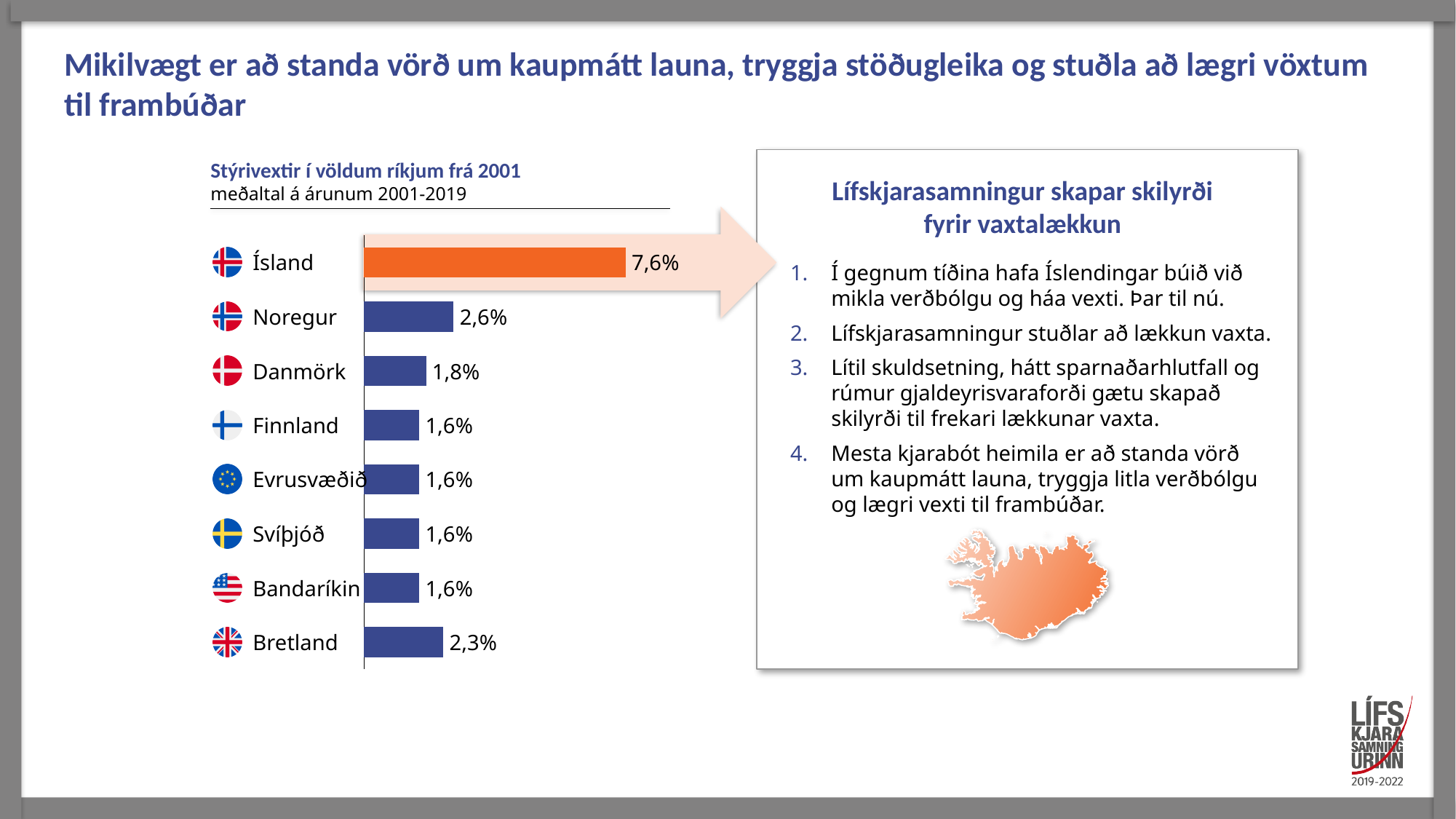
Which is larger, the value for Noregur or the value for Bretland? Noregur What is the value for Noregur? 2,6% What is the value for Bretland? 2,3% Which country has the highest value in the chart? Ísland What is the value for Danmörk? 1,8% What is the value for Ísland? 7,6% How many categories are shown in the chart? 8 What kind of chart is shown on the slide? Bar chart How many categories share the value 1,6%? 4 What is the difference between the values for Ísland and Noregur? 5,0% What is the difference between the values for Bretland and Danmörk? 0,5% What is the title of the chart? Stýrivextir í völdum ríkjum frá 2001